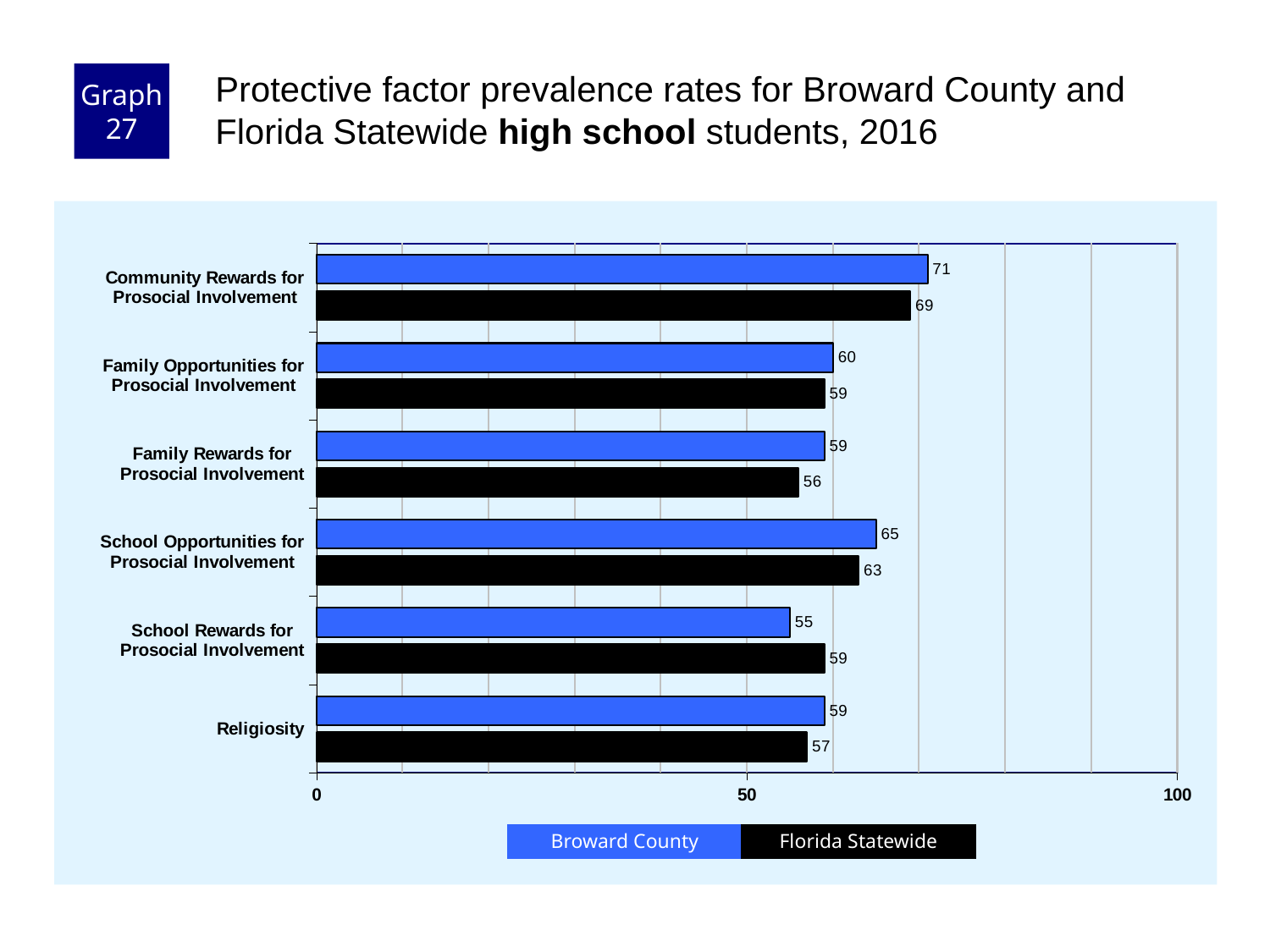
Which category has the lowest Broward County value? School Rewards for Prosocial Involvement Which category has the highest Broward County value? Community Rewards for Prosocial Involvement Is the Broward County value for School Opportunities for Prosocial Involvement greater or less than 50? greater What is the Florida Statewide value for School Rewards for Prosocial Involvement? 59 What is the Florida Statewide value for Religiosity? 57 For Family Rewards for Prosocial Involvement, which is larger: the Broward County value or the Florida Statewide value? Broward County How many categories are shown on the chart? 6 Which category has the lowest Florida Statewide value? Family Rewards for Prosocial Involvement How many series does the legend list? 2 What is the Broward County value for Community Rewards for Prosocial Involvement? 71 What is the difference between the Broward County and Florida Statewide values for School Rewards for Prosocial Involvement? 4 What kind of chart is shown on the slide? Bar chart